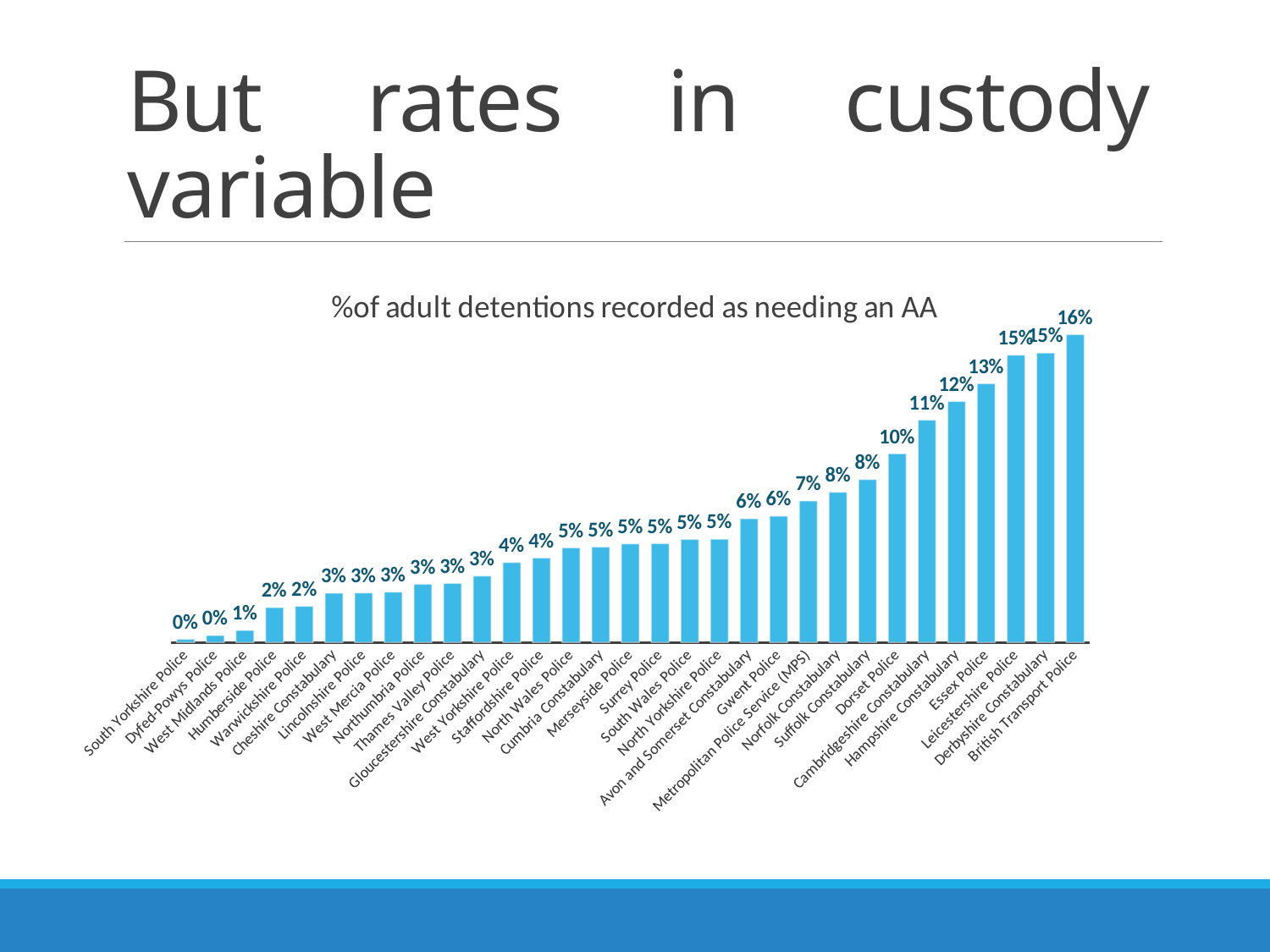
What is the difference between the values for Essex Police and Hampshire Constabulary? 1% What is the value for British Transport Police? 16% Do the values rise or fall from left to right along the x axis? Rise What kind of chart is shown on the slide? Bar chart How many police forces are shown in the chart? 31 What is the value for Metropolitan Police Service (MPS)? 7% Which police force has the highest percentage of adult detentions recorded as needing an AA? British Transport Police What is the title of the chart? %of adult detentions recorded as needing an AA What is the value for West Midlands Police? 1% Which is larger, the value for Cambridgeshire Constabulary or the value for Suffolk Constabulary? Cambridgeshire Constabulary What is the value for Dorset Police? 10% What is the difference between the values for British Transport Police and Dorset Police? 6%